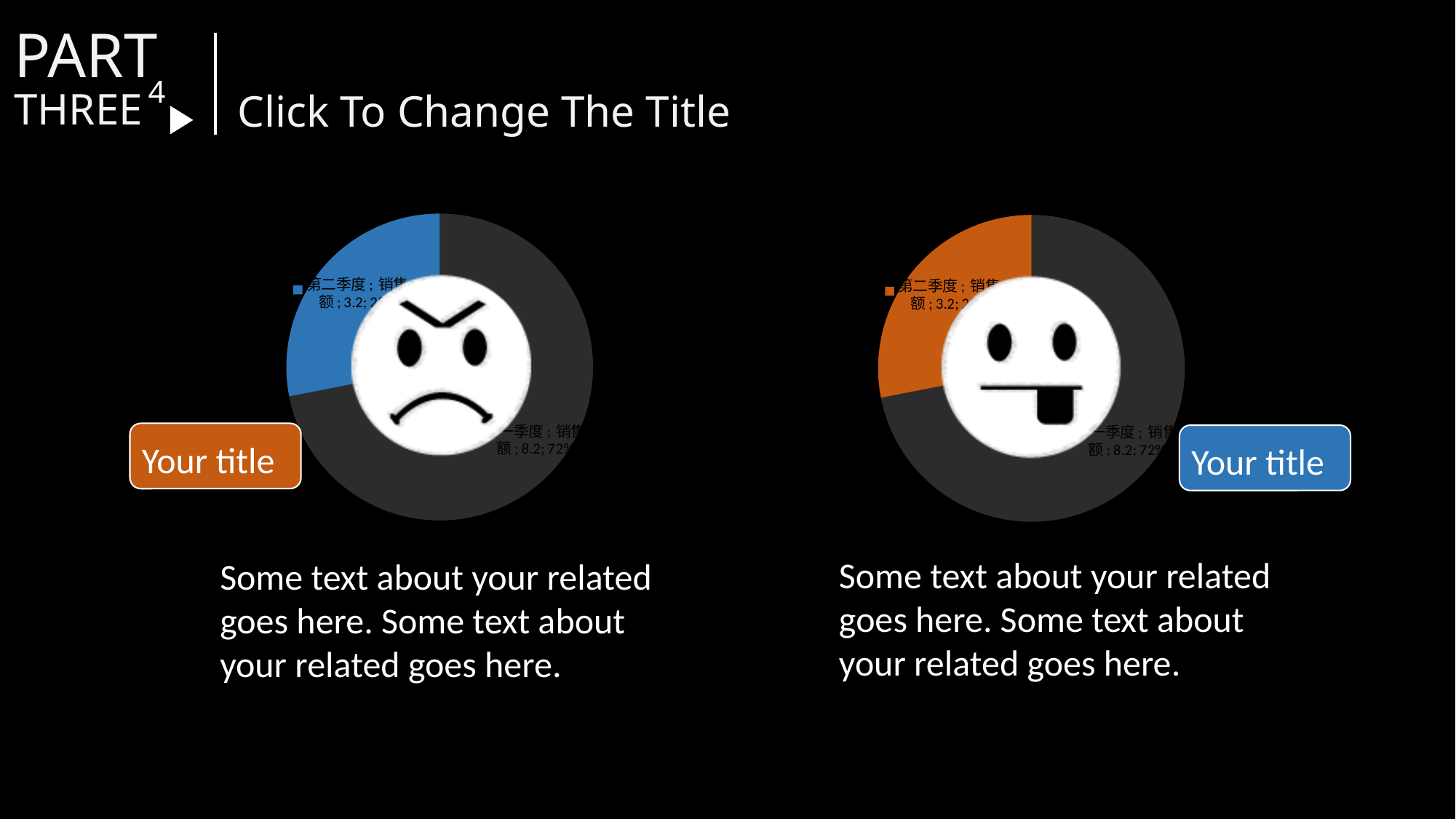
In the left pie chart, which category has the largest slice? 第一季度 What kind of chart is the left chart on the slide? doughnut chart In the right pie chart, what is the value for 第二季度? 3.2 In the right pie chart, what is the value for 第一季度? 8.2 In the left pie chart, how many slices are there? 2 In the right pie chart, what colour is the 第二季度 slice? orange In the left pie chart, what is the value for 第一季度? 8.2 In the left pie chart, what is the value for 第二季度? 3.2 In the left pie chart, what share of the pie does 第一季度 take? 72% In the right pie chart, which category has the smallest slice? 第二季度 What kind of chart is the right chart on the slide? doughnut chart In the right pie chart, what share of the pie does 第一季度 take? 72%